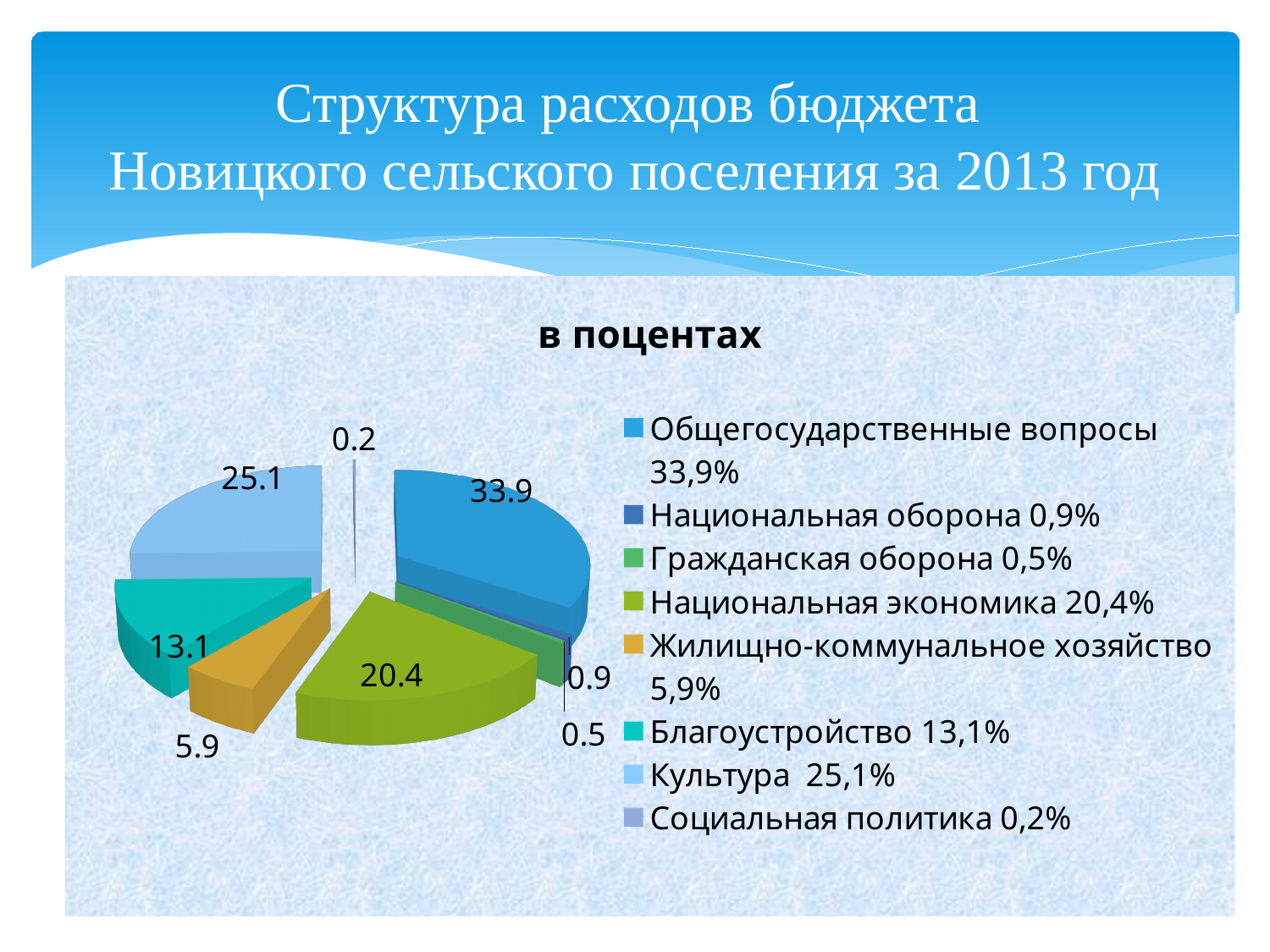
What is the difference between the values for Культура and Национальная экономика? 4.7 Which category has the largest slice of the pie? Общегосударственные вопросы What is the value shown for Национальная экономика? 20.4 Which is larger, the value for Жилищно-коммунальное хозяйство or the value for Благоустройство? Благоустройство What is the value shown for Социальная политика? 0.2 What kind of chart is shown on the slide? pie chart What is the value shown for Благоустройство? 13.1 What is the value shown for Общегосударственные вопросы? 33.9 Which category has the smallest slice of the pie? Социальная политика How many slices does the pie chart have? 8 What is the title of the chart? в поцентах What is the difference between the values for Национальная оборона and Гражданская оборона? 0.4